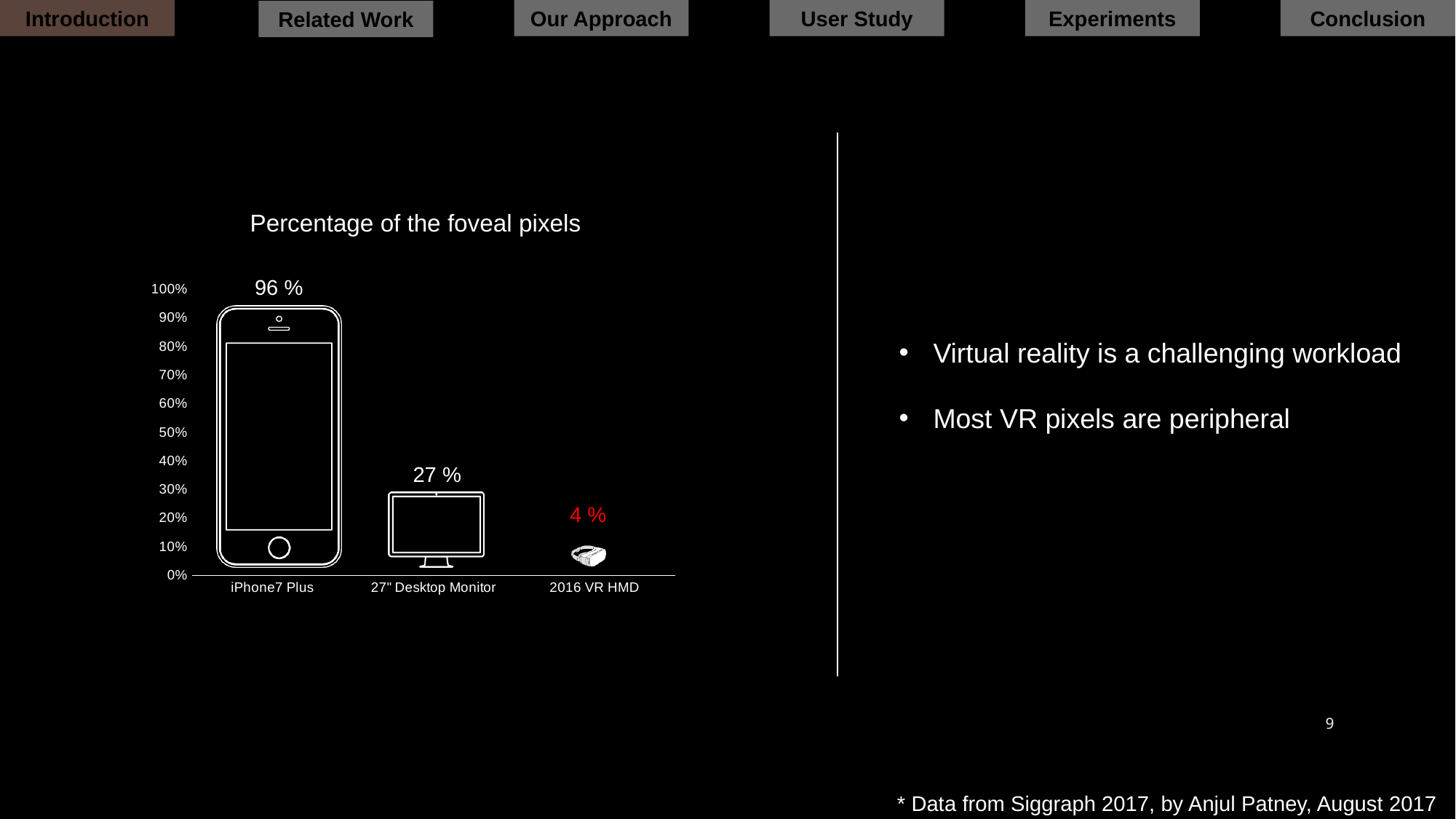
What is the difference in foveal pixel percentage between the 27" Desktop Monitor and the 2016 VR HMD? 23 % Which has a larger percentage of foveal pixels, the 27" Desktop Monitor or the 2016 VR HMD? 27" Desktop Monitor What is the percentage of foveal pixels for the 27" Desktop Monitor? 27 % How many devices are shown in the chart? 3 Which device has the highest percentage of foveal pixels? iPhone7 Plus What is the difference in foveal pixel percentage between the iPhone7 Plus and the 27" Desktop Monitor? 69 % What is the percentage of foveal pixels for the iPhone7 Plus? 96 % What kind of chart is shown on the slide? bar chart Which device has the lowest percentage of foveal pixels? 2016 VR HMD What is the title of the chart? Percentage of the foveal pixels What is the percentage of foveal pixels for the 2016 VR HMD? 4 % Is the value for the 27" Desktop Monitor greater or less than 50%? less